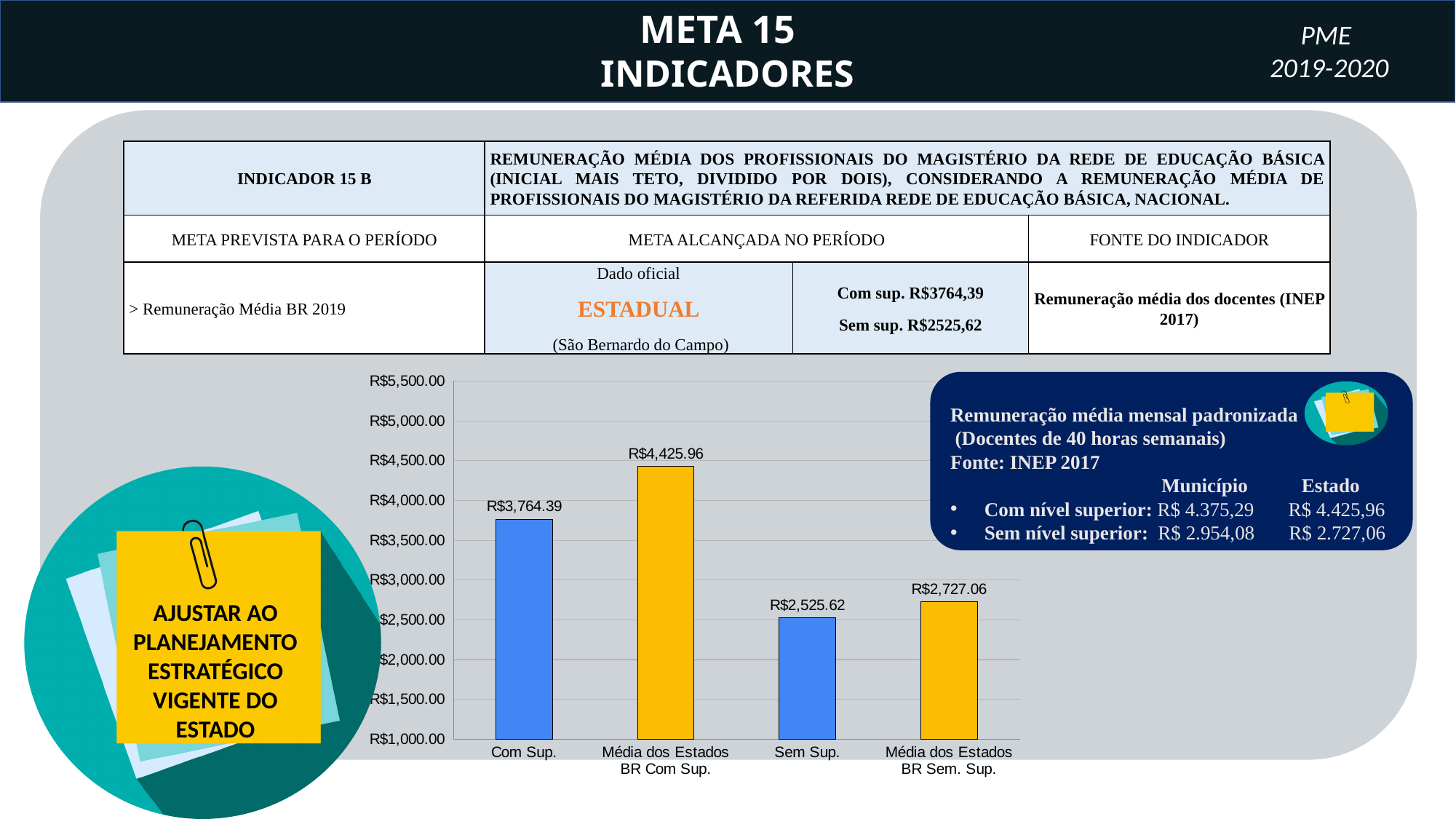
What is the value of the Média dos Estados BR Com Sup. bar? R$4,425.96 Is the value for Com Sup. greater or less than R$3,500.00? greater What is the difference between the Média dos Estados BR Com Sup. value and the Com Sup. value? R$661.57 What is the difference between the Média dos Estados BR Sem. Sup. value and the Sem Sup. value? R$201.44 How many bars are shown in the chart? 4 What is the value of the Sem Sup. bar? R$2,525.62 What type of chart is shown on the slide? Bar chart Which category has the lowest value in the chart? Sem Sup. What is the value of the Com Sup. bar? R$3,764.39 Which is larger, the Com Sup. value or the Sem Sup. value? Com Sup. Which category has the highest value in the chart? Média dos Estados BR Com Sup. What is the value of the Média dos Estados BR Sem. Sup. bar? R$2,727.06